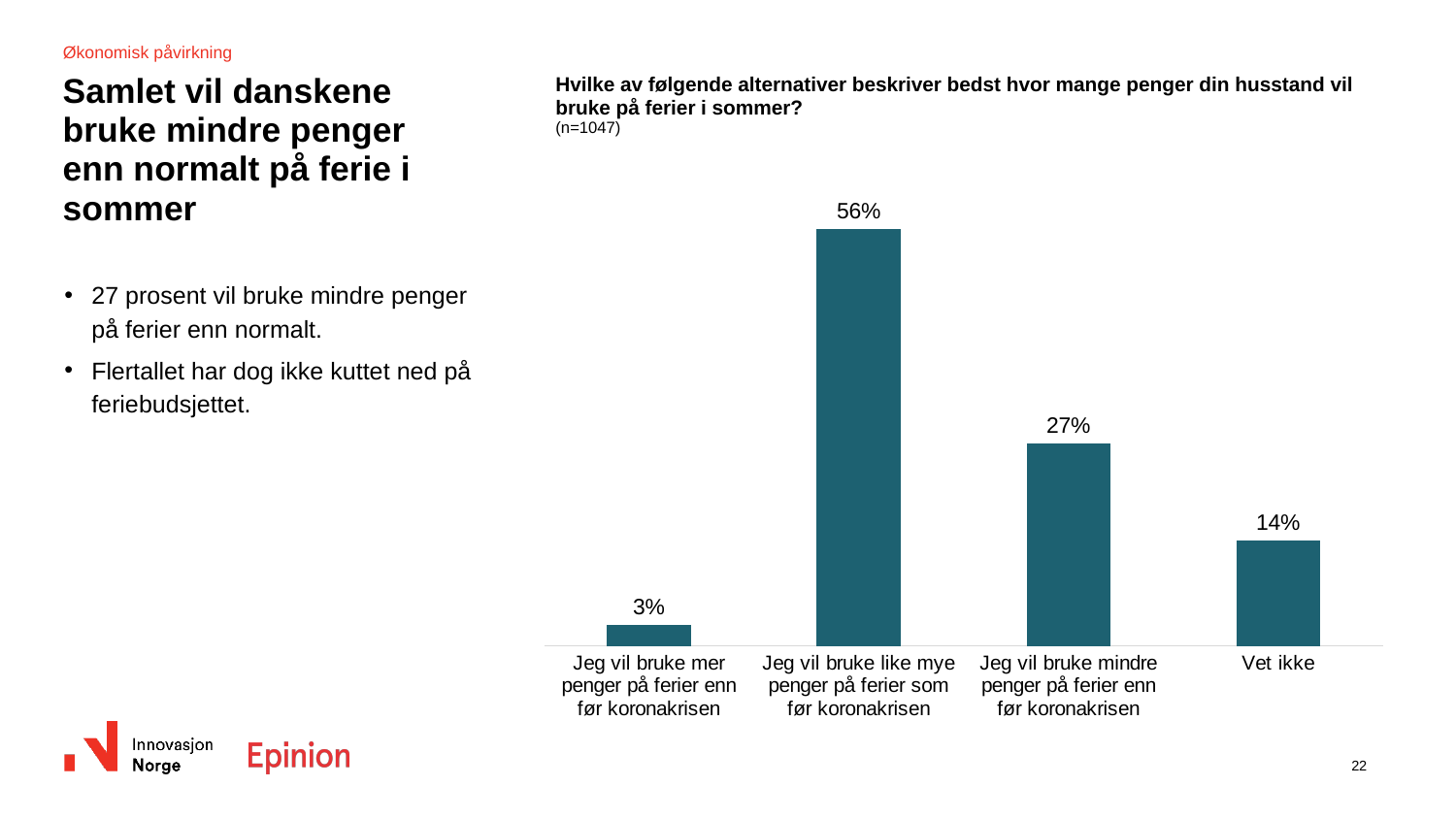
How many categories are shown in the chart? 4 What is the value for "Jeg vil bruke mindre penger på ferier enn før koronakrisen"? 27% What is the difference between the values for "Jeg vil bruke like mye penger på ferier som før koronakrisen" and "Jeg vil bruke mindre penger på ferier enn før koronakrisen"? 29% What is the difference between the values for "Jeg vil bruke mindre penger på ferier enn før koronakrisen" and "Vet ikke"? 13% What kind of chart is shown on the slide? Bar chart What is the sample size (n) stated in the chart title? n=1047 What percentage answered "Vet ikke"? 14% Which is larger: the value for "Vet ikke" or the value for "Jeg vil bruke mer penger på ferier enn før koronakrisen"? Vet ikke Which category has the lowest value? Jeg vil bruke mer penger på ferier enn før koronakrisen What percentage of respondents chose "Jeg vil bruke like mye penger på ferier som før koronakrisen"? 56% Which category has the highest value? Jeg vil bruke like mye penger på ferier som før koronakrisen What is the value for "Jeg vil bruke mer penger på ferier enn før koronakrisen"? 3%